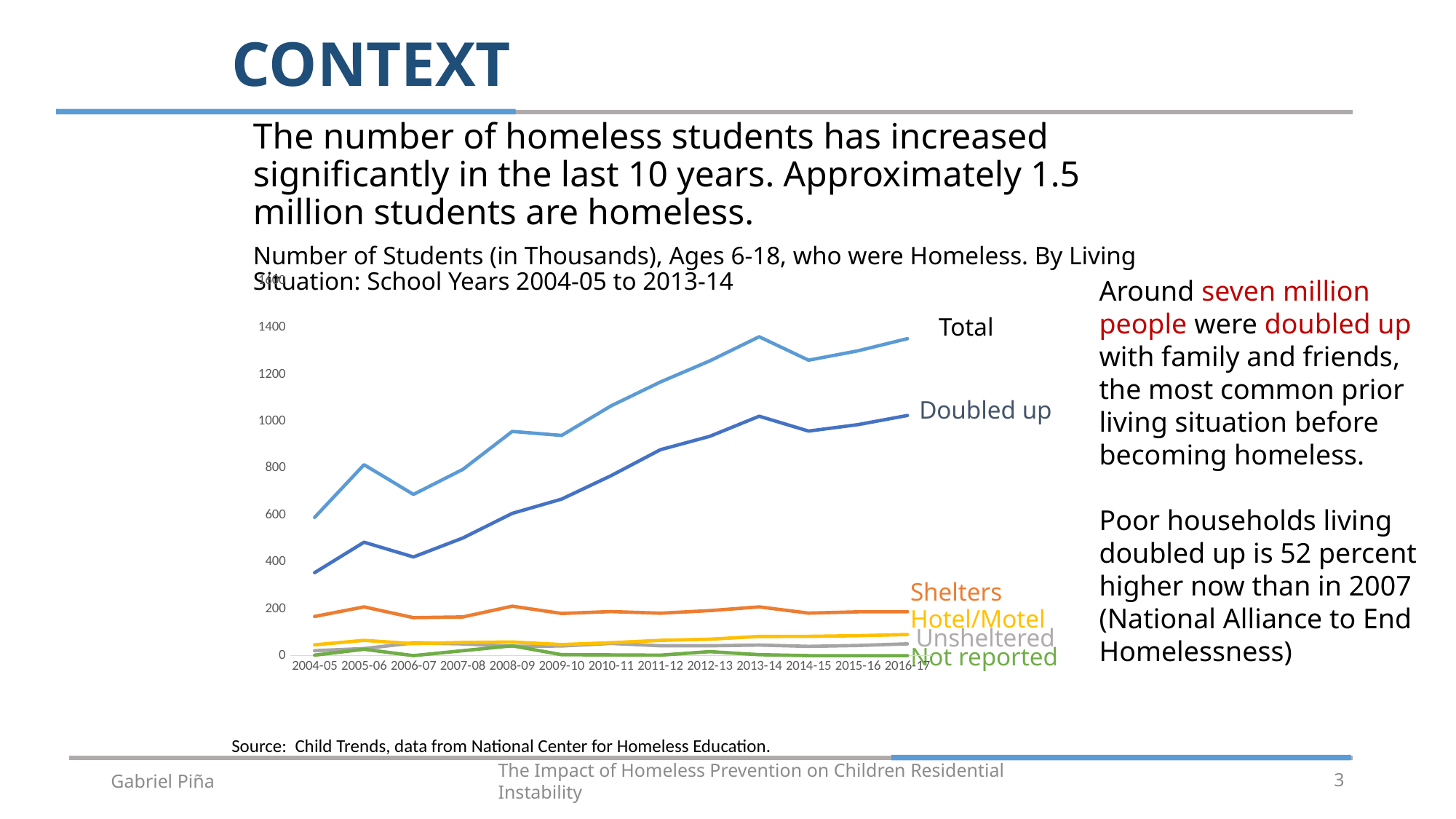
How many data series are labelled on the chart? 6 Does the Total series generally rise or fall from 2004-05 to 2016-17? rise What is the first school year shown on the x axis of the chart? 2004-05 In 2010-11, which is larger: Shelters or Hotel/Motel? Shelters Which series has the lowest values on the chart? Not reported In 2016-17, which is larger: Total or Doubled up? Total How many school years are plotted along the x axis of the chart? 13 Is the value for Doubled up in 2004-05 greater or less than 400? less Which series has the highest values throughout the chart? Total Is the value for Shelters in 2008-09 greater or less than 400? less Is the value for Total in 2013-14 greater or less than 1200? greater What kind of chart is shown on the slide? line chart